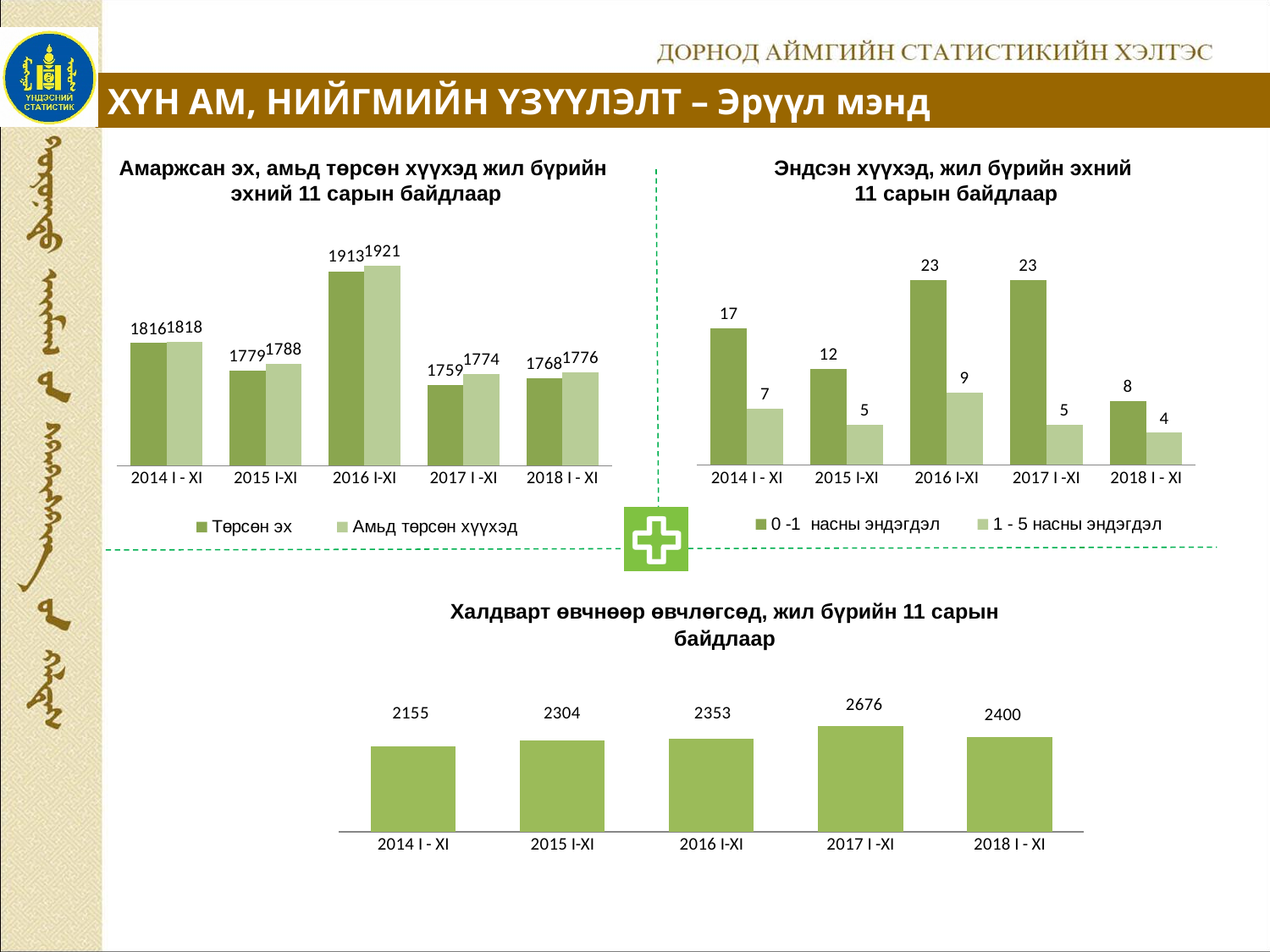
In the top-right chart (Эндсэн хүүхэд), what is the value for 1-5 насны эндэгдэл in 2016 I-XI? 9 In the top-left chart (Амаржсан эх, амьд төрсөн хүүхэд), which year has the lowest value for Төрсөн эх? 2017 I-XI In the bottom chart (Халдварт өвчнөөр өвчлөгсөд), which year has the highest value? 2017 I-XI In the top-left chart (Амаржсан эх, амьд төрсөн хүүхэд), what is the difference between Амьд төрсөн хүүхэд and Төрсөн эх in 2015 I-XI? 9 In the top-left chart (Амаржсан эх, амьд төрсөн хүүхэд), what is the value for Төрсөн эх in 2016 I-XI? 1913 In the top-left chart (Амаржсан эх, амьд төрсөн хүүхэд), what is the value for Амьд төрсөн хүүхэд in 2017 I-XI? 1774 In the top-right chart (Эндсэн хүүхэд), what is the difference between 0-1 насны эндэгдэл and 1-5 насны эндэгдэл in 2017 I-XI? 18 How many series does the legend of the top-left chart (Амаржсан эх, амьд төрсөн хүүхэд) list? 2 In the top-right chart (Эндсэн хүүхэд), which year has the lowest value for 0-1 насны эндэгдэл? 2018 I-XI In the top-right chart (Эндсэн хүүхэд), what is the value for 0-1 насны эндэгдэл in 2014 I-XI? 17 In the bottom chart (Халдварт өвчнөөр өвчлөгсөд), what is the value for 2017 I-XI? 2676 What kind of chart is the bottom chart (Халдварт өвчнөөр өвчлөгсөд)? Bar chart